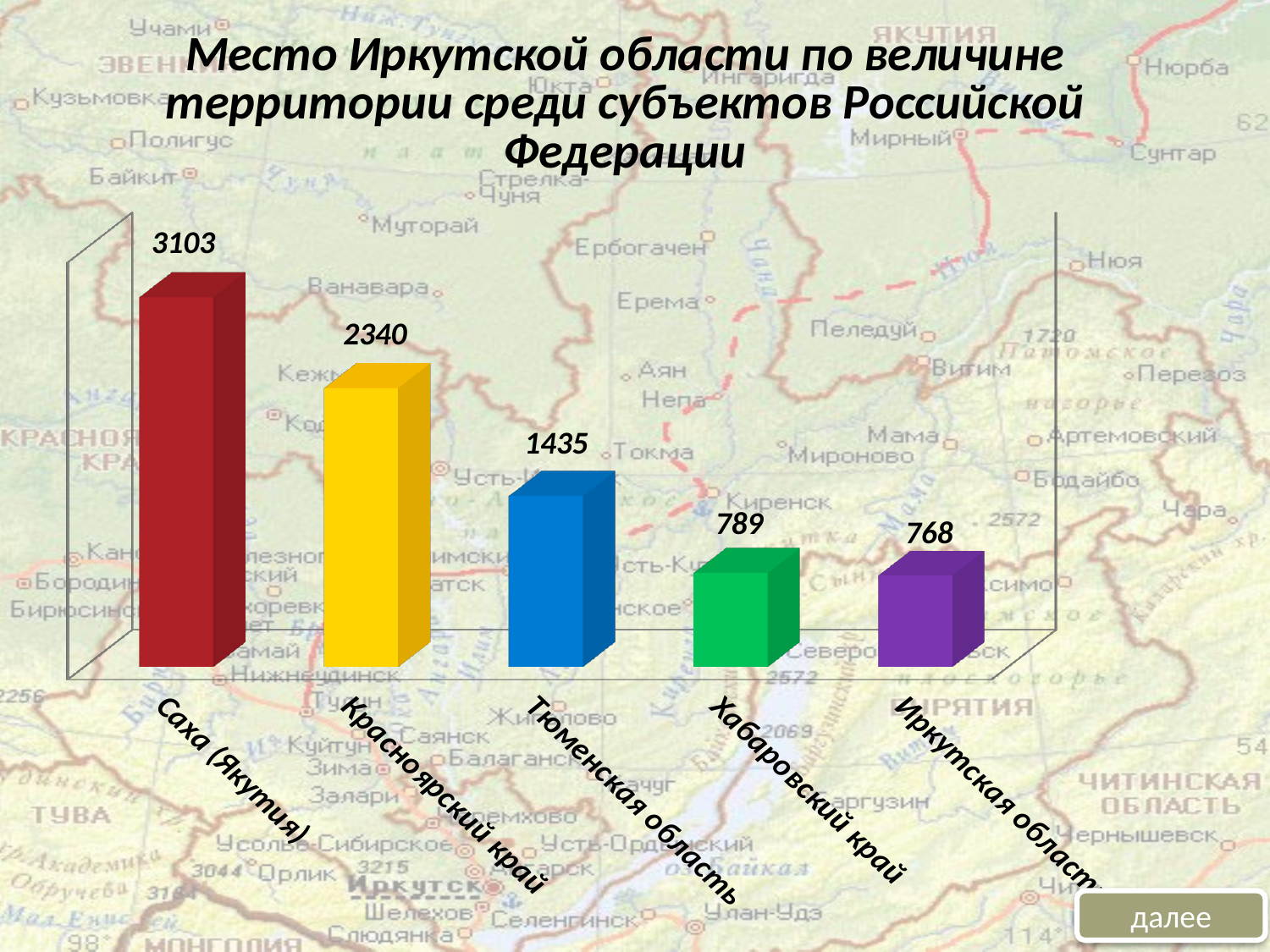
Do the values rise or fall from left to right across the categories? Fall How many categories are shown in the chart? 5 Which category has the highest value? Саха (Якутия) What kind of chart is shown on the slide? Bar chart Which category has the lowest value? Иркутская область What is the difference between the values for Саха (Якутия) and Красноярский край? 763 What is the difference between the values for Хабаровский край and Иркутская область? 21 What is the value shown for Тюменская область? 1435 What is the value shown for Иркутская область? 768 Which is larger, the value for Красноярский край or the value for Тюменская область? Красноярский край What is the value shown for Красноярский край? 2340 What is the value shown for Саха (Якутия)? 3103